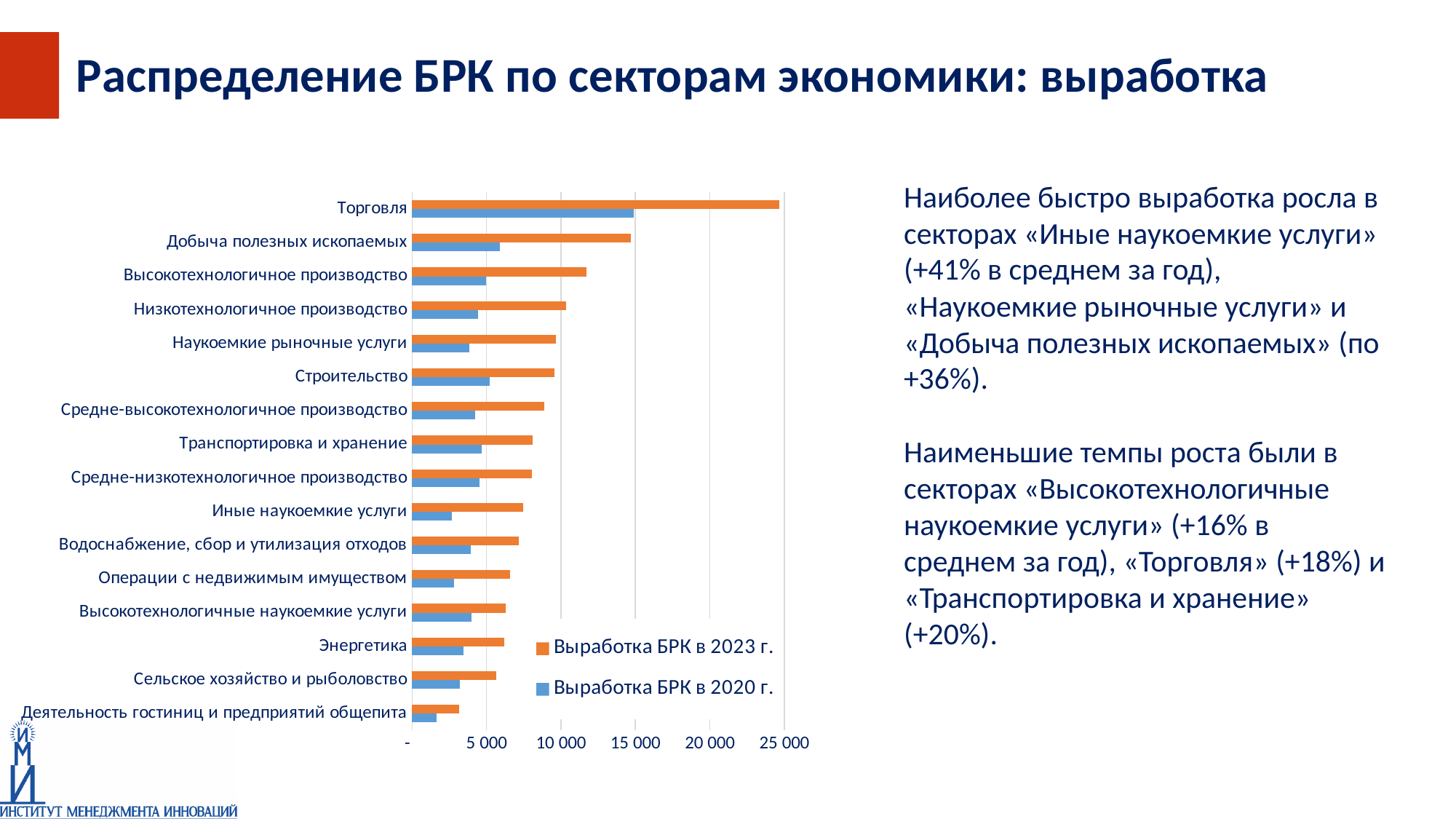
How many sectors (categories) are plotted on the chart? 16 Is the value for Высокотехнологичное производство in 2023 greater or less than 10 000? greater Which sector has the highest value for Выработка БРК в 2020 г.? Торговля Which colour represents Выработка БРК в 2020 г. in the chart? Blue Which is larger in 2020: the value for Строительство or the value for Иные наукоемкие услуги? Строительство Is the value for Иные наукоемкие услуги in 2020 greater or less than 5 000? less Which sector has the lowest value for Выработка БРК в 2023 г.? Деятельность гостиниц и предприятий общепита Is the value for Торговля in 2023 greater or less than 20 000? greater How many series does the legend list? 2 What kind of chart is shown on the slide? Bar chart Which sector has the highest value for Выработка БРК в 2023 г.? Торговля